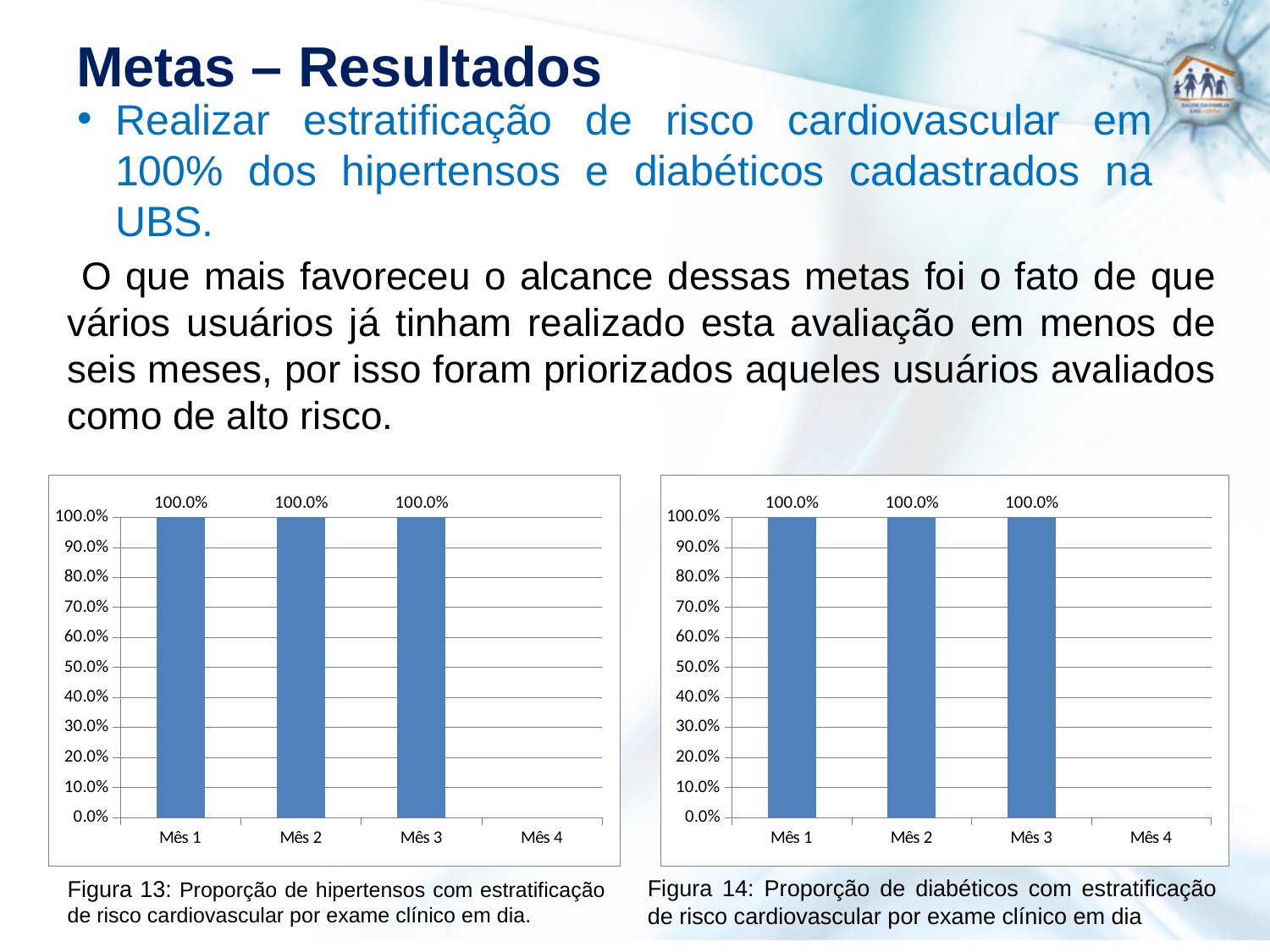
In the left chart (Figura 13), what is the difference between the values for Mês 1 and Mês 2? 0.0% In the left chart (Figura 13), what is the value for Mês 1? 100.0% In the left chart (Figura 13), what is the value for Mês 3? 100.0% In the right chart (Figura 14), is the value for Mês 1 greater or less than 50.0%? greater In the left chart (Figura 13), how many categories are shown on the x axis? 4 In the right chart (Figura 14), what is the value for Mês 3? 100.0% In the right chart (Figura 14), do the values change from Mês 1 to Mês 3? No, they stay at 100.0% According to its caption, what does the right chart (Figura 14) show the proportion of? Diabéticos com estratificação de risco cardiovascular por exame clínico em dia In the right chart (Figura 14), what is the value for Mês 2? 100.0% In the left chart (Figura 13), what kind of chart is shown? bar chart In the right chart (Figura 14), how many categories are shown on the x axis? 4 In the left chart (Figura 13), is the value for Mês 2 greater or less than 90.0%? greater